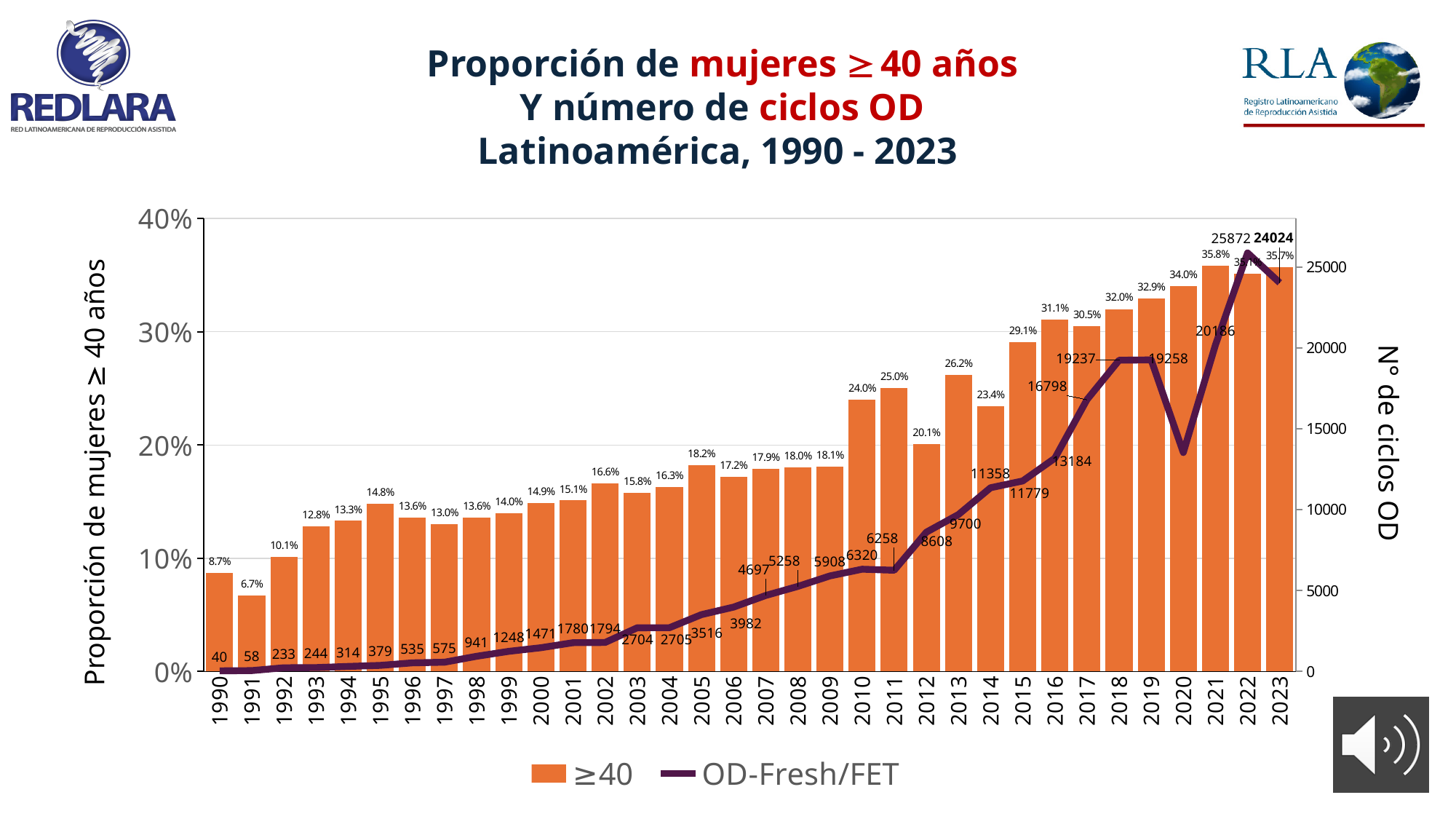
How many years are shown on the x axis? 34 How many OD-Fresh/FET cycles are shown for 2017? 16798 How many OD-Fresh/FET cycles are shown for 1990? 40 What proportion of women ≥40 years is shown for 2010? 24.0% Which year has the higher proportion of women ≥40 years, 2012 or 2013? 2013 In which year does the OD-Fresh/FET line reach its highest value? 2022 By how much did the number of OD-Fresh/FET cycles fall from 2022 to 2023? 1848 What kind of chart is this? Combined bar and line chart Which year has the lowest proportion of women ≥40 years? 1991 Is the number of OD-Fresh/FET cycles in 2020 greater or less than 15000? less How many series does the legend list? 2 Does the number of OD-Fresh/FET cycles generally rise or fall from 1990 to 2023? Rise